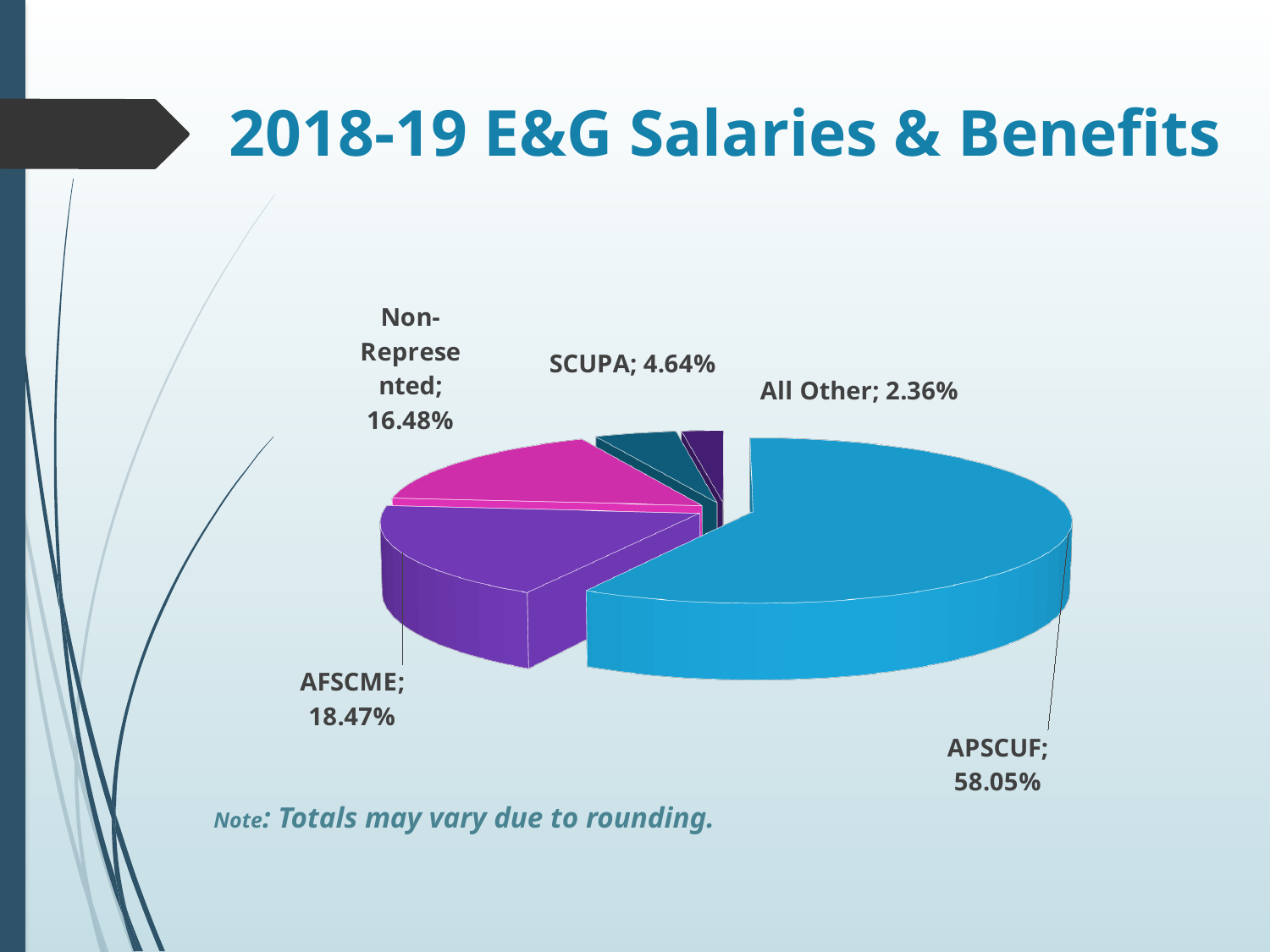
Which category has the largest slice of the pie? APSCUF What is the title of the chart on the slide? 2018-19 E&G Salaries & Benefits What share of the pie does All Other represent? 2.36% What kind of chart is shown on the slide? Pie chart What is the difference between the AFSCME share and the Non-Represented share? 1.99% Which category has the smallest slice of the pie? All Other What share of the pie does SCUPA represent? 4.64% What share of the pie does Non-Represented represent? 16.48% How many slices does the pie chart have? 5 What share of the pie does AFSCME represent? 18.47% What share of the pie does APSCUF represent? 58.05% Which is larger, the SCUPA share or the All Other share? SCUPA